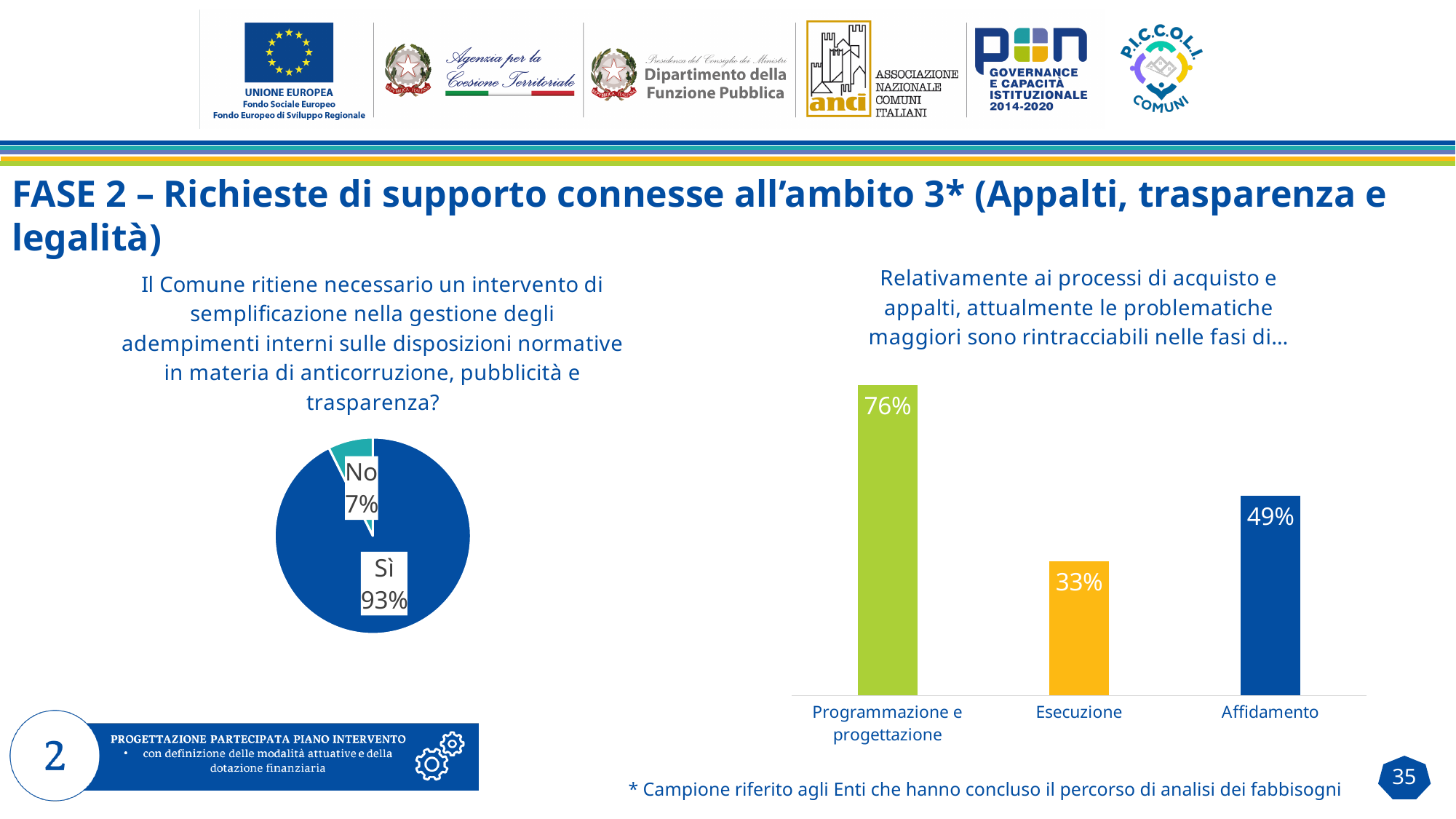
In the bar chart on the right, which category has the lowest value? Esecuzione What kind of chart is the chart on the left? Pie chart In the bar chart on the right, which category has the highest value? Programmazione e progettazione How many categories are shown in the bar chart on the right? 3 In the bar chart on the right, what is the value for 'Affidamento'? 49% In the pie chart on the left, what is the difference between the 'Sì' and 'No' shares? 86% In the bar chart on the right, what is the difference between 'Programmazione e progettazione' and 'Affidamento'? 27% In the pie chart on the left, what percentage answered 'Sì'? 93% In the bar chart on the right, what is the value for 'Programmazione e progettazione'? 76% In the bar chart on the right, what is the value for 'Esecuzione'? 33% In the pie chart on the left, which slice is larger, 'Sì' or 'No'? Sì In the pie chart on the left, what percentage answered 'No'? 7%